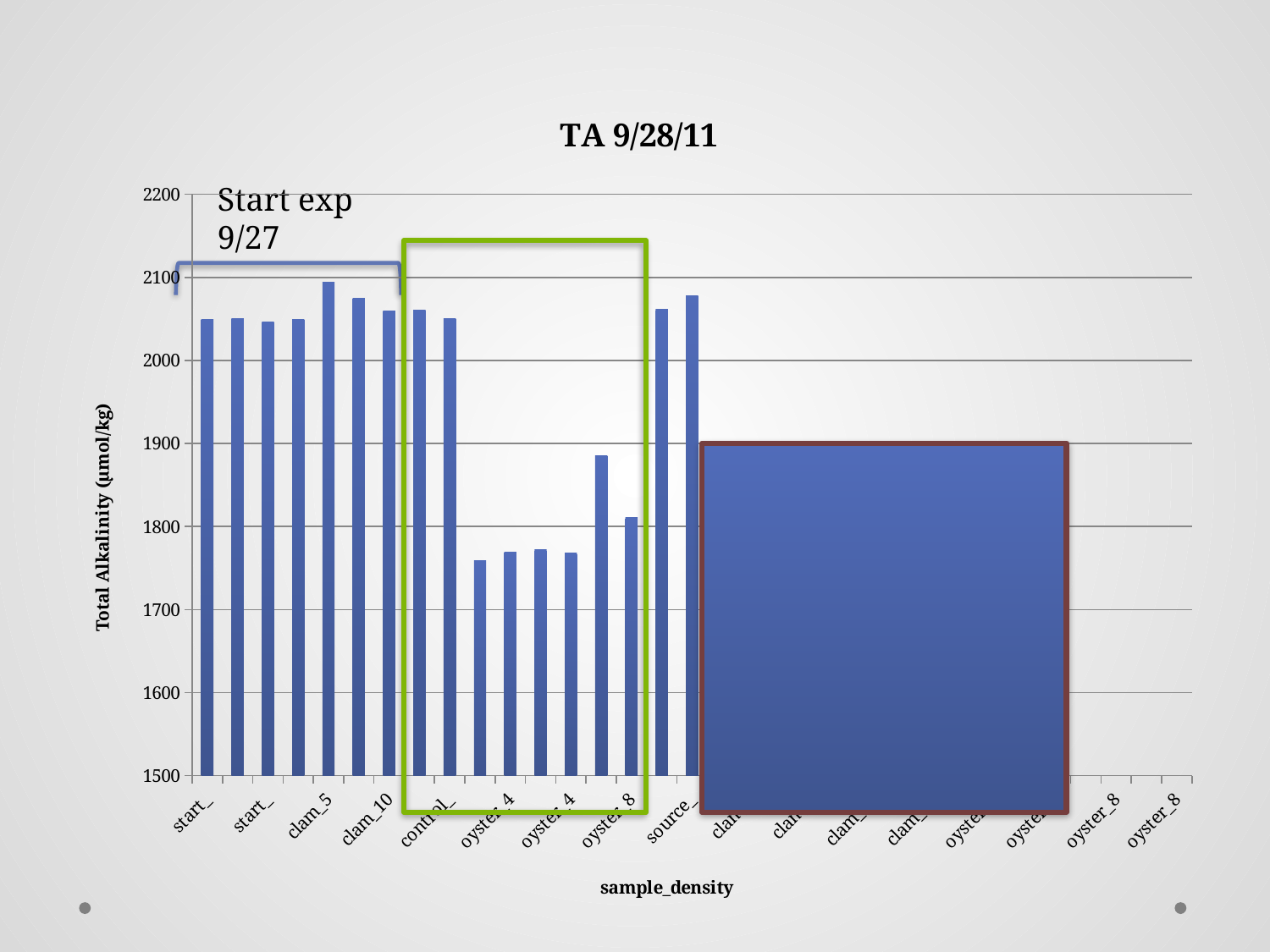
What is the title of the chart? TA 9/28/11 What is the label of the vertical axis? Total Alkalinity (µmol/kg) What is the lowest value shown on the vertical axis? 1500 Is the leftmost bar taller or shorter than the shortest bar inside the green box? taller Is the value of the leftmost bar greater or less than 2000? greater Is the value of the shortest visible bar greater or less than 1800? less What kind of chart is shown on the slide? bar chart Is the value of the shortest visible bar greater or less than 1700? greater